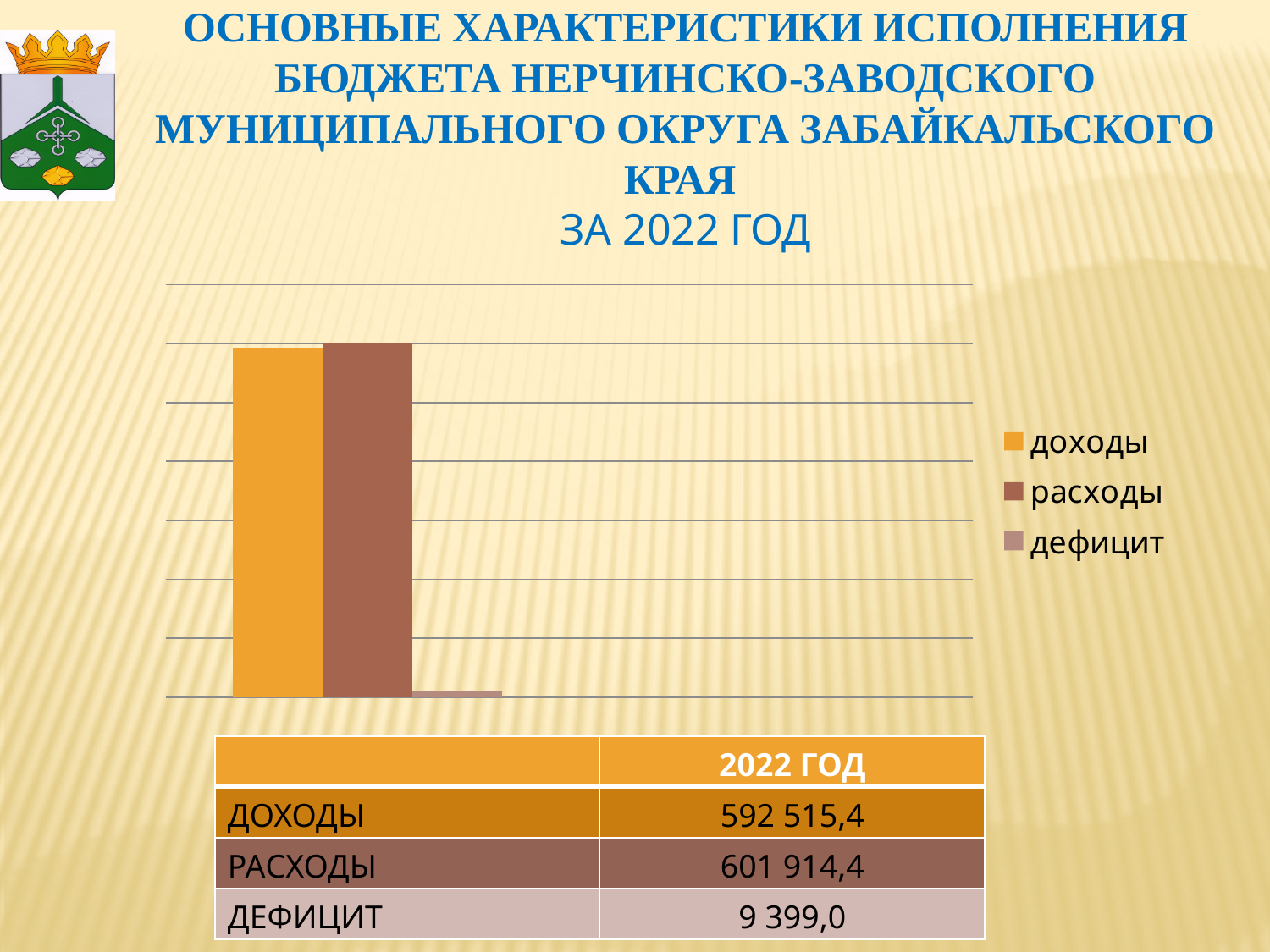
Which is larger, the bar for доходы or the bar for дефицит? доходы How many bars are plotted in the chart? 3 Which series has the tallest bar in the chart? расходы Using the values in the table, what is the difference between РАСХОДЫ and ДОХОДЫ for 2022? 9 399,0 What colour is the bar for доходы in the chart? orange According to the table under the chart, what is the value of РАСХОДЫ for 2022? 601 914,4 Which is larger, the bar for доходы or the bar for расходы? расходы According to the table under the chart, what is the value of ДЕФИЦИТ for 2022? 9 399,0 According to the table under the chart, what is the value of ДОХОДЫ for 2022? 592 515,4 How many series does the chart legend list? 3 What kind of chart is shown on the slide? bar chart Which series has the shortest bar in the chart? дефицит